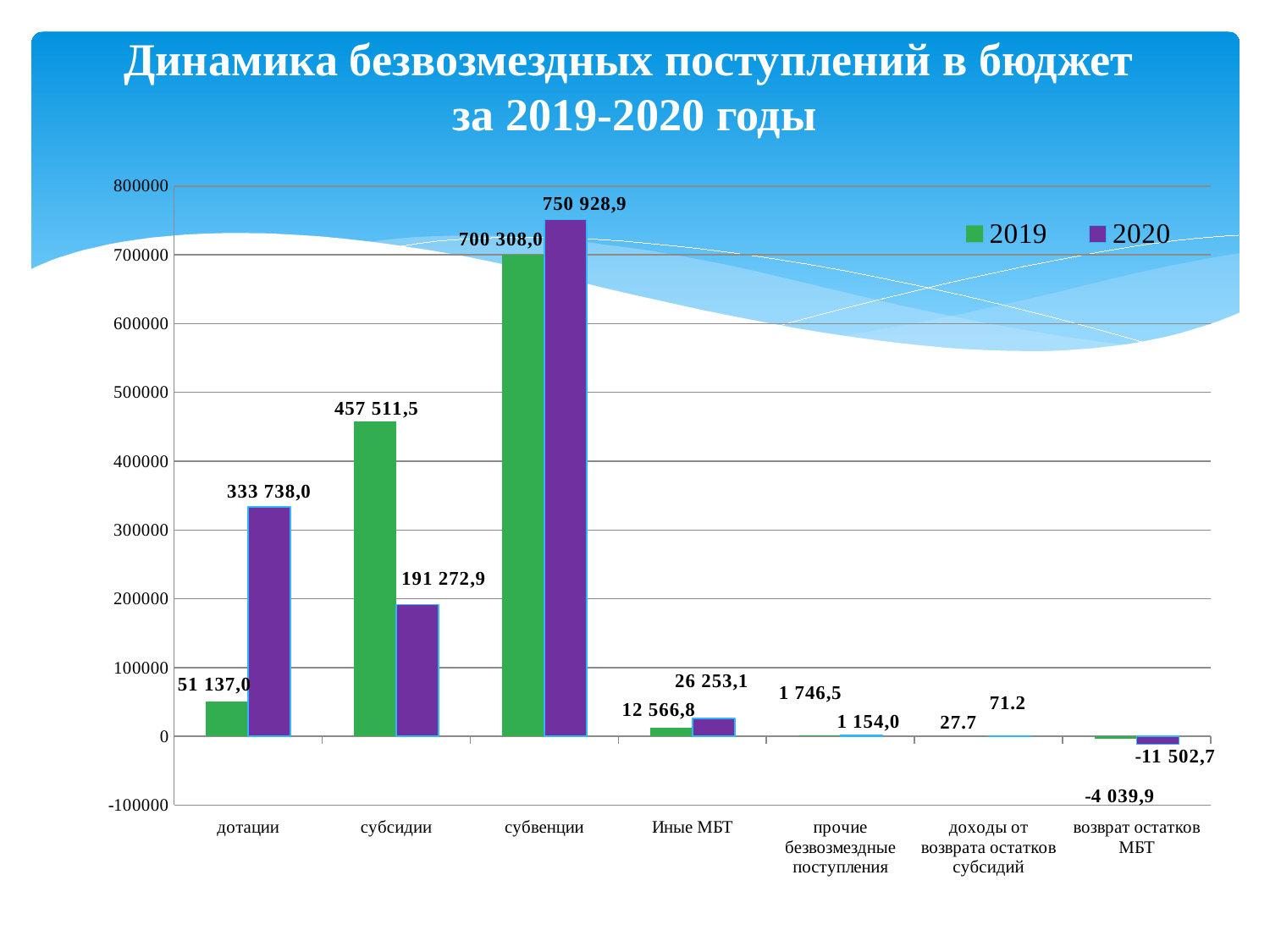
How many categories are shown on the x axis? 7 What is the 2019 value for Иные МБТ? 12 566,8 What is the 2020 value for субвенции? 750 928,9 What kind of chart is shown on the slide? bar chart What is the 2020 value for дотации? 333 738,0 Which category has the highest 2019 value? субвенции What is the difference between the 2020 and 2019 values for субвенции? 50 620,9 Which category has the lowest 2020 value? возврат остатков МБТ How many series does the legend list? 2 What is the 2020 value for возврат остатков МБТ? -11 502,7 For субсидии, which year has the larger value, 2019 or 2020? 2019 What is the 2019 value for субсидии? 457 511,5